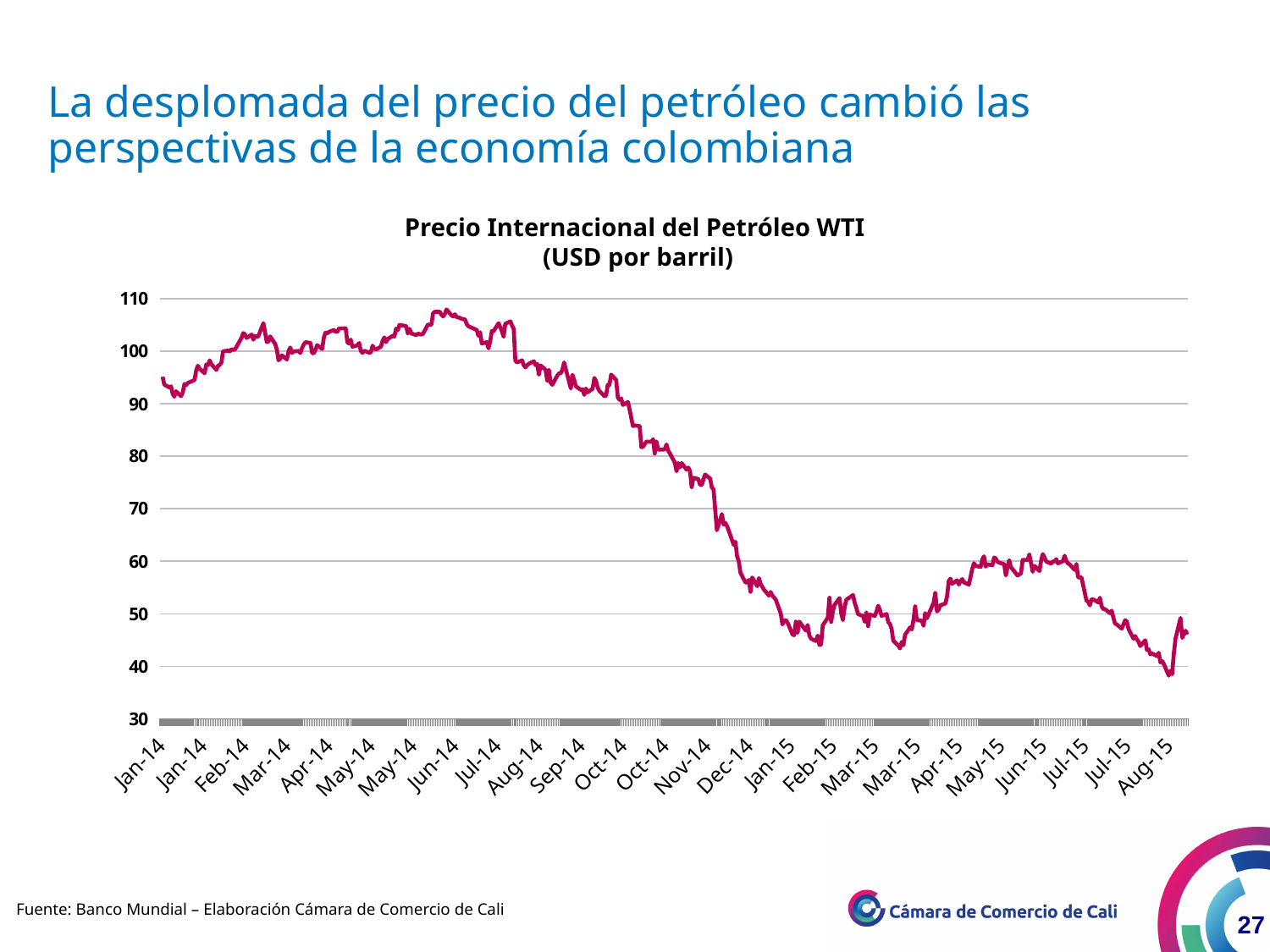
How many lines (series) are plotted on the chart? 1 What is the title of the chart? Precio Internacional del Petróleo WTI (USD por barril) Around which month does the line reach its lowest point? Aug-15 Which is higher, the WTI price at Jun-14 or at Jun-15? Jun-14 Is the WTI price at Dec-14 greater or less than 70? less Is the WTI price at Jan-14 greater or less than 90? greater Overall, does the WTI oil price rise or fall from Jan-14 to Aug-15? fall Is the WTI price at Mar-15 greater or less than 60? less What kind of chart is shown on the slide? line chart Around which month does the line reach its highest point? Jun-14